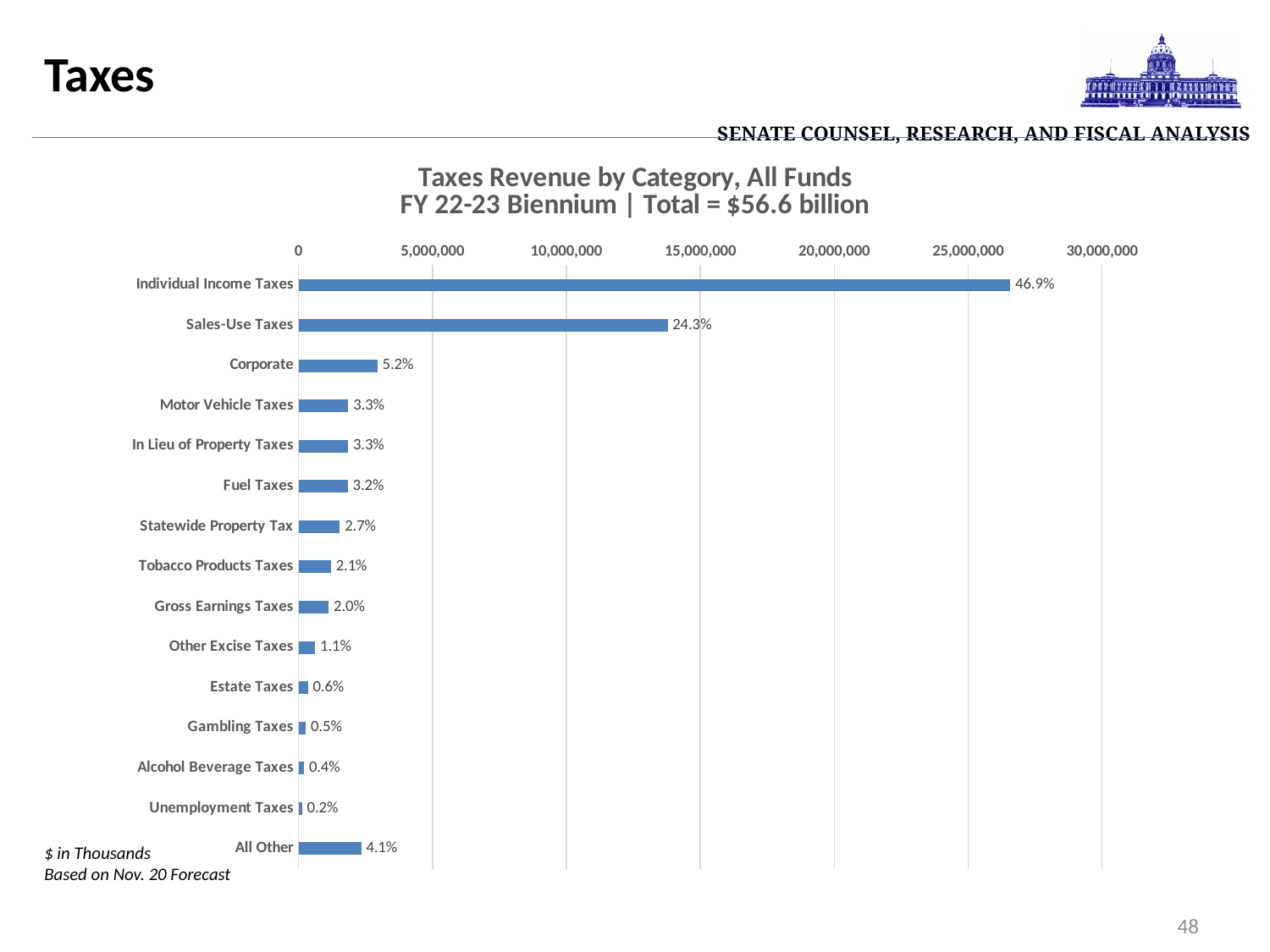
What kind of chart is shown on the slide? Bar chart Which category has the largest bar? Individual Income Taxes What is the difference in percentage points between the labels for Individual Income Taxes and Sales-Use Taxes? 22.6 What percentage label is shown for Sales-Use Taxes? 24.3% Is the value for Sales-Use Taxes greater or less than 15,000,000? less What percentage label is shown for Corporate? 5.2% What percentage label is shown for Individual Income Taxes? 46.9% Which is larger, the bar for Corporate or the bar for All Other? Corporate What percentage label is shown for Tobacco Products Taxes? 2.1% Is the value for Individual Income Taxes greater or less than 25,000,000? greater How many categories are shown in the chart? 15 Which category has the smallest bar? Unemployment Taxes